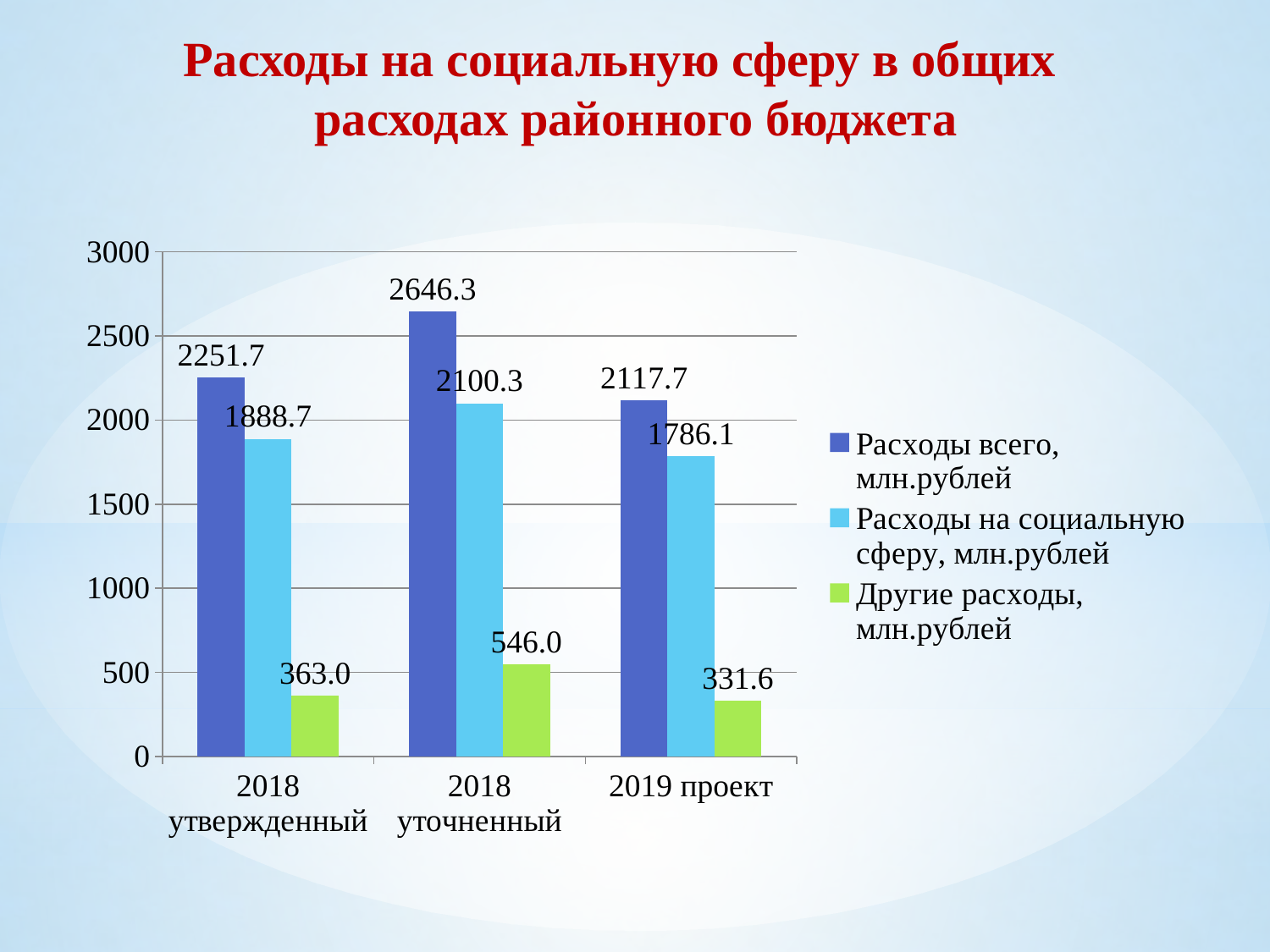
How many categories are shown on the x axis? 3 Is the value of "Другие расходы, млн.рублей" for "2018 уточненный" greater or less than 500? greater Which category has the lowest value for "Другие расходы, млн.рублей"? 2019 проект What kind of chart is shown on the slide? bar chart What is the difference between "Расходы всего, млн.рублей" and "Расходы на социальную сферу, млн.рублей" for "2018 утвержденный"? 363.0 How many series does the legend list? 3 Which is larger: "Расходы на социальную сферу, млн.рублей" for "2018 уточненный" or for "2019 проект"? 2018 уточненный What is the value of "Расходы на социальную сферу, млн.рублей" for "2019 проект"? 1786.1 What is the title of the slide? Расходы на социальную сферу в общих расходах районного бюджета What is the value of "Другие расходы, млн.рублей" for "2018 утвержденный"? 363.0 What is the value of "Расходы всего, млн.рублей" for "2018 уточненный"? 2646.3 Which category has the highest value for "Расходы всего, млн.рублей"? 2018 уточненный